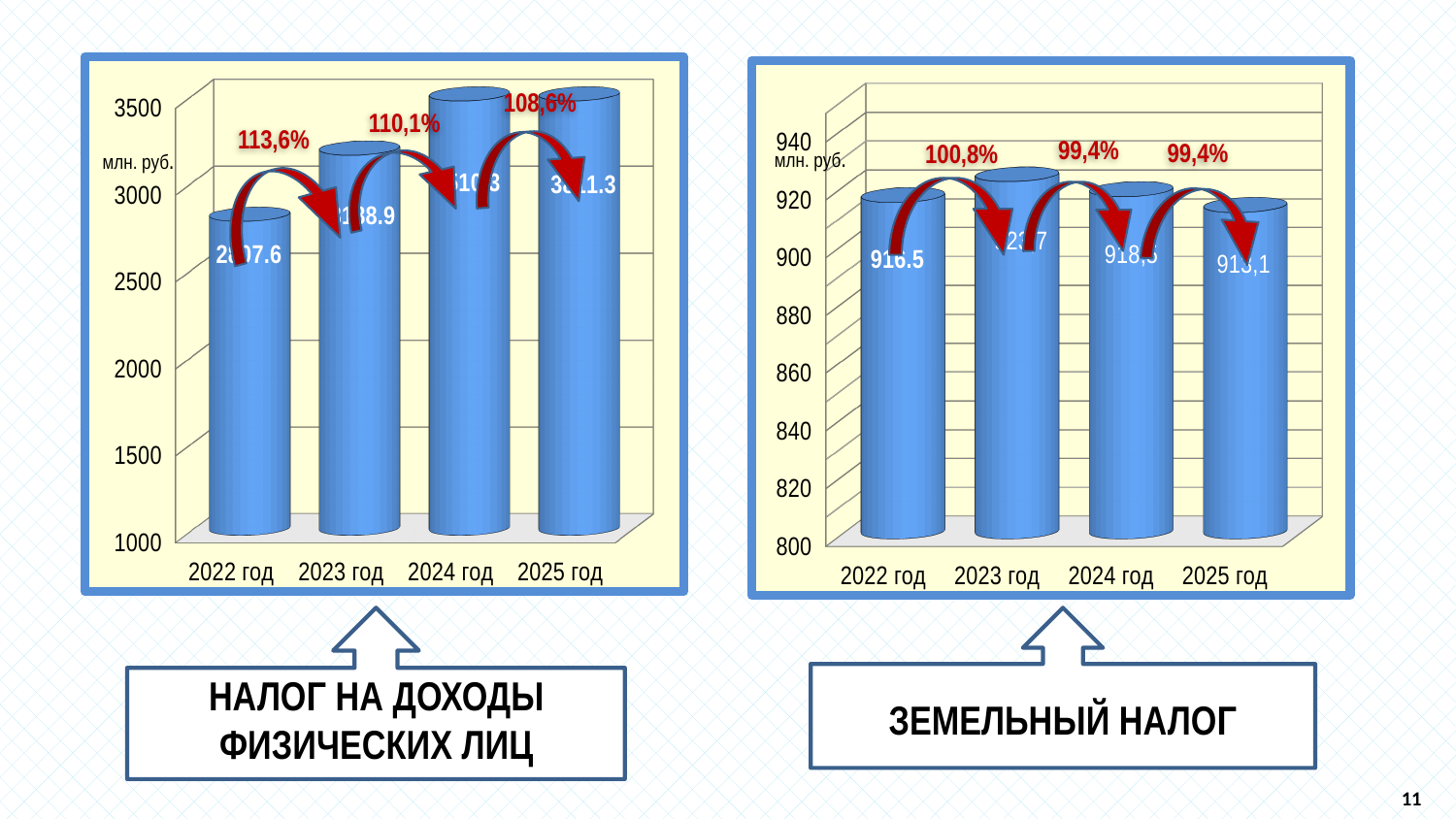
On the right chart (ЗЕМЕЛЬНЫЙ НАЛОГ), is the value for 2022 год greater or less than 900? greater On the left chart (НАЛОГ НА ДОХОДЫ ФИЗИЧЕСКИХ ЛИЦ), do the bars rise or fall from 2022 год to 2025 год? rise On the right chart (ЗЕМЕЛЬНЫЙ НАЛОГ), what is the value for 2022 год? 916.5 On the left chart (НАЛОГ НА ДОХОДЫ ФИЗИЧЕСКИХ ЛИЦ), what percentage is shown on the arrow from 2022 год to 2023 год? 113,6% On the left chart (НАЛОГ НА ДОХОДЫ ФИЗИЧЕСКИХ ЛИЦ), is the value for 2022 год greater or less than 3000? less On the left chart (НАЛОГ НА ДОХОДЫ ФИЗИЧЕСКИХ ЛИЦ), what percentage is shown on the arrow from 2024 год to 2025 год? 108,6% What kind of chart is the left chart (НАЛОГ НА ДОХОДЫ ФИЗИЧЕСКИХ ЛИЦ)? bar chart On the left chart (НАЛОГ НА ДОХОДЫ ФИЗИЧЕСКИХ ЛИЦ), which year has the lowest bar? 2022 год On the right chart (ЗЕМЕЛЬНЫЙ НАЛОГ), what percentage is shown on the arrow from 2022 год to 2023 год? 100,8% What unit is written on the vertical axis of the right chart (ЗЕМЕЛЬНЫЙ НАЛОГ)? млн. руб. How many years are shown on the left chart (НАЛОГ НА ДОХОДЫ ФИЗИЧЕСКИХ ЛИЦ)? 4 On the right chart (ЗЕМЕЛЬНЫЙ НАЛОГ), which year has the highest bar? 2023 год